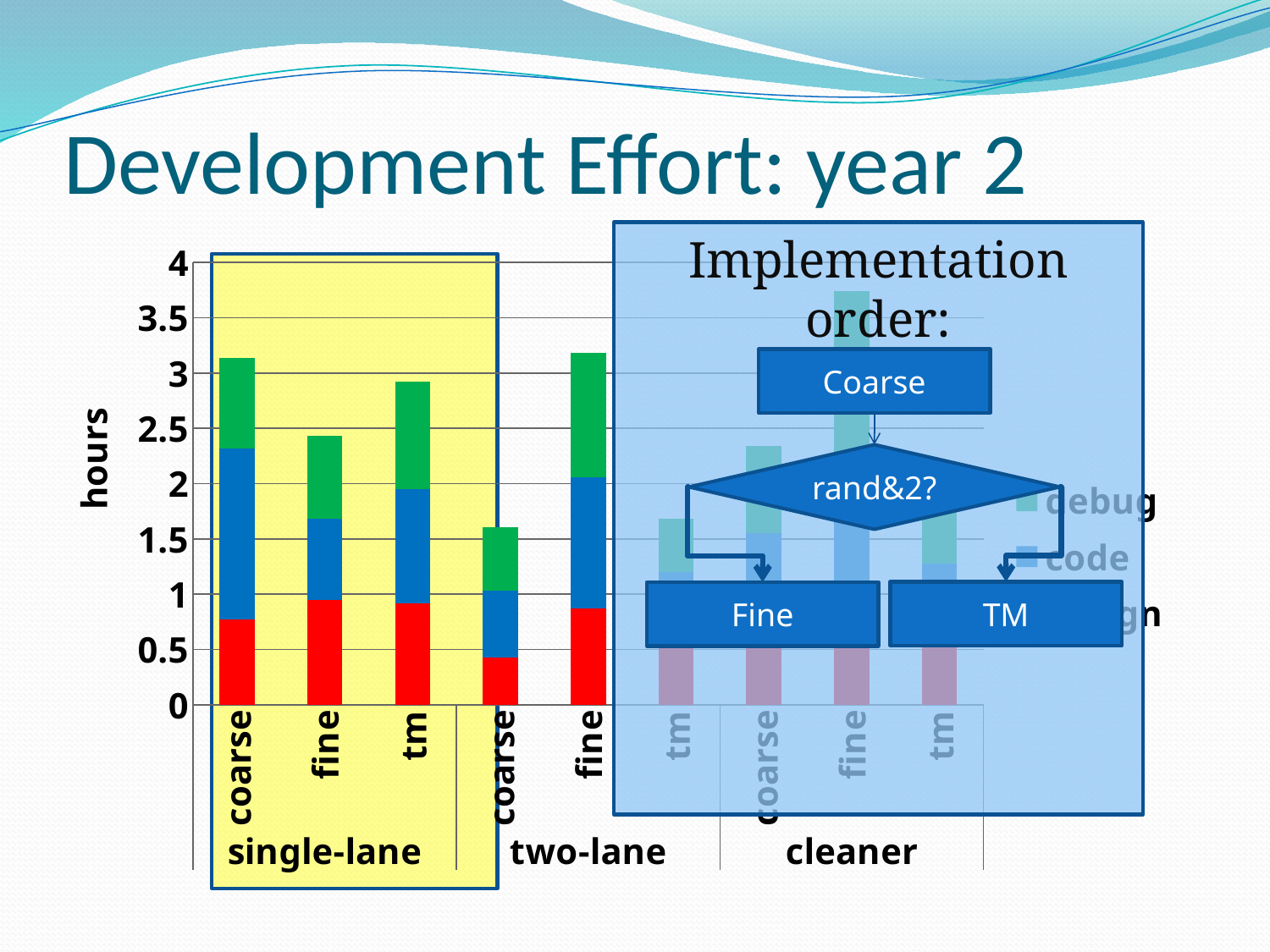
Is the total bar height for coarse in the single-lane group greater or less than 3 hours? greater Is the total bar height for fine in the two-lane group greater or less than 3 hours? greater Which has the taller total bar in the two-lane group, coarse or fine? fine Is the total bar height for coarse in the two-lane group greater or less than 2 hours? less What kind of chart is shown on the slide? bar chart Within the single-lane group, which category has the lowest total bar? fine Which has the taller total bar in the single-lane group, coarse or fine? coarse What is the label on the vertical axis of the chart? hours Which legend entry is shown in green? debug